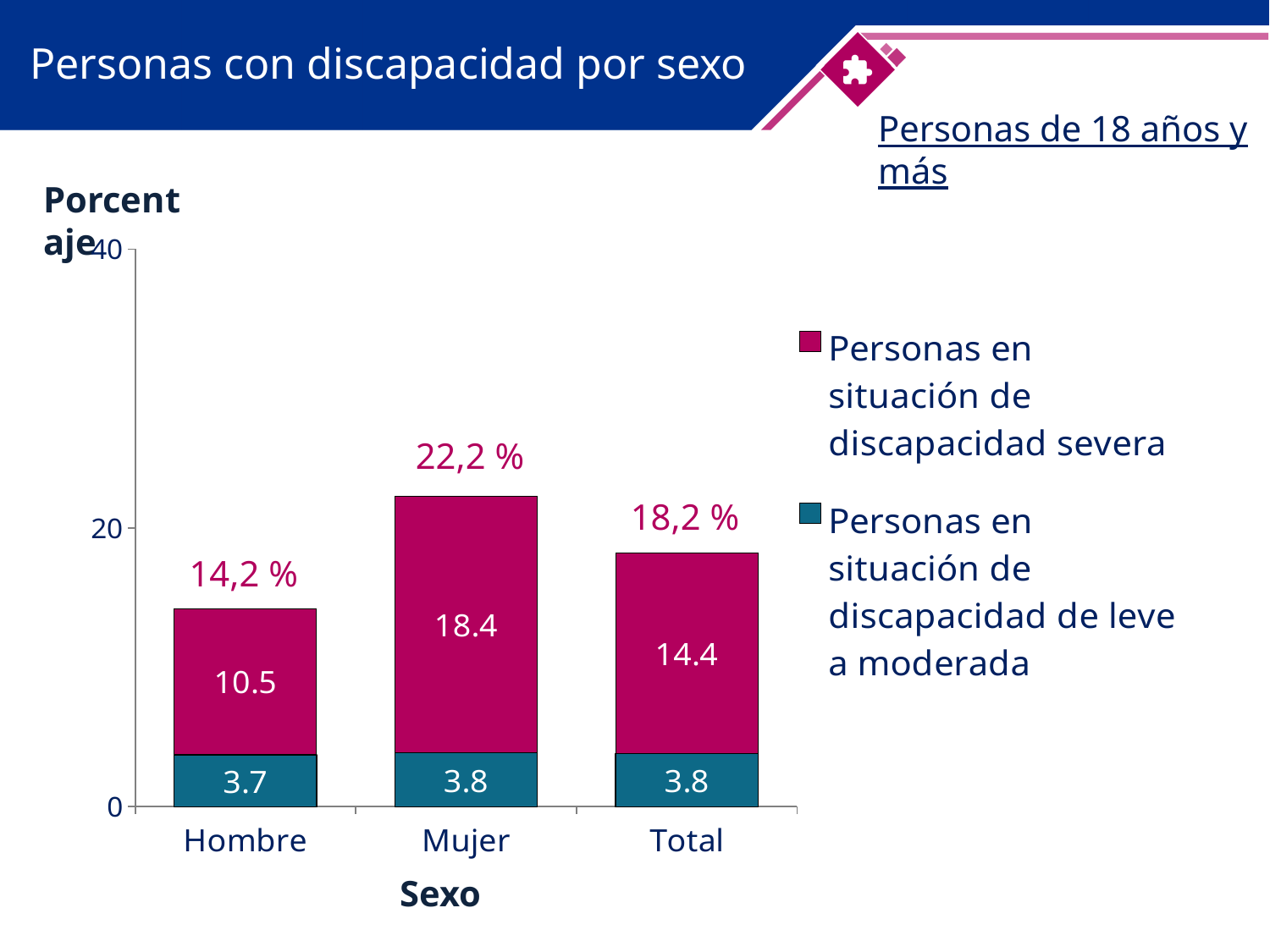
Is the 'discapacidad severa' value for Hombre larger or smaller than the value for Total? Smaller What is the total labelled above the Mujer bar? 22,2 % What is the difference between the 'discapacidad severa' values for Mujer and Hombre? 7.9 How many series does the legend list? 2 What is the value for 'Personas en situación de discapacidad de leve a moderada' for Hombre? 3.7 Which category has the highest value for 'Personas en situación de discapacidad severa'? Mujer What kind of chart is shown on the slide? Stacked bar chart What is the value for 'Personas en situación de discapacidad severa' for Mujer? 18.4 Which category has the lowest value for 'Personas en situación de discapacidad de leve a moderada'? Hombre How many categories are shown on the x axis? 3 What is the value for 'Personas en situación de discapacidad severa' for Total? 14.4 What is the total labelled above the Hombre bar? 14,2 %